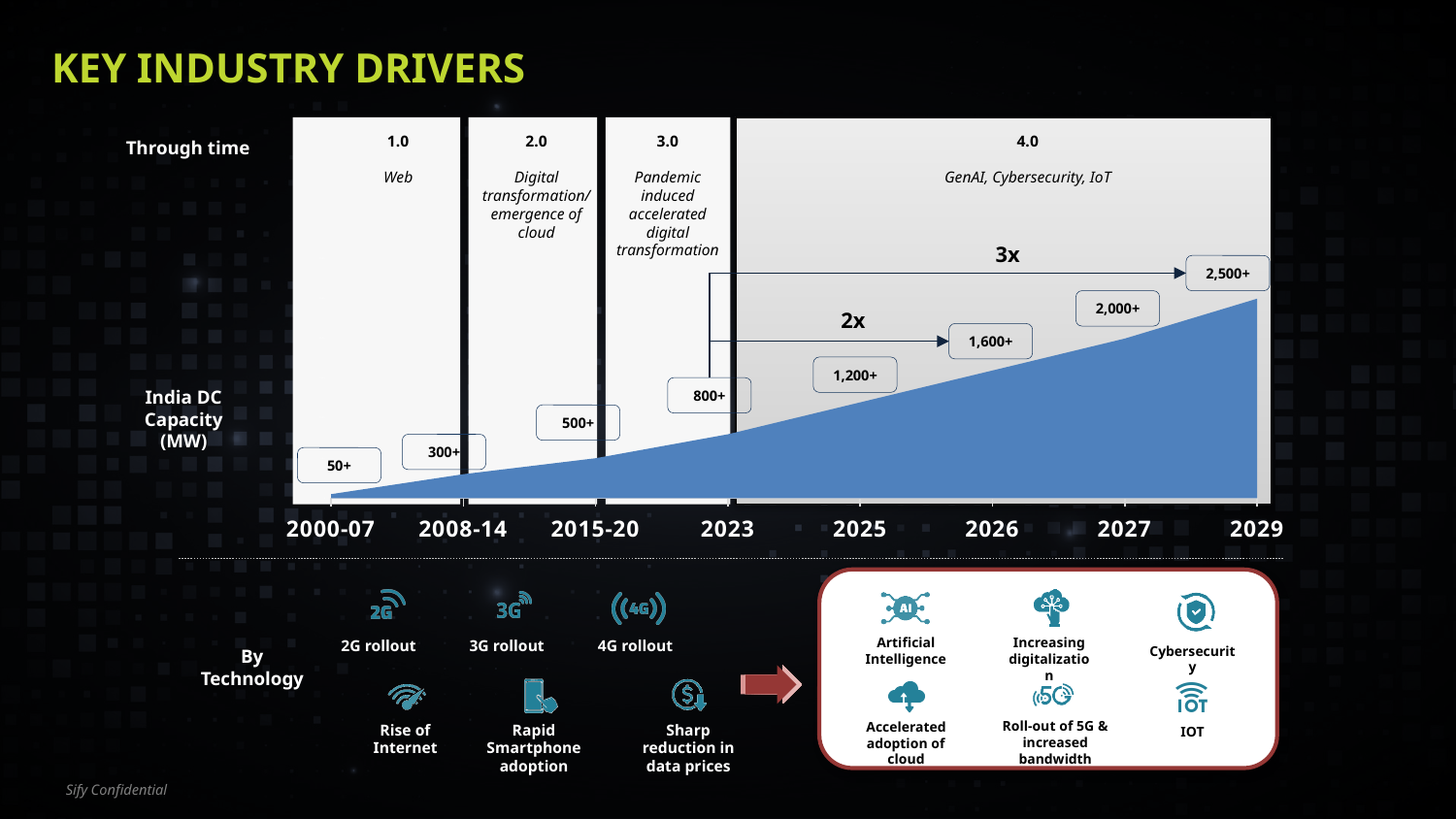
What is the India DC Capacity (MW) shown for 2000-07? 50+ How many time periods are labelled on the x axis of the India DC Capacity chart? 8 What multiplier is annotated between the 2023 capacity and the 2029 capacity? 3x What is the India DC Capacity (MW) shown for 2015-20? 500+ What kind of chart is used to show India DC Capacity (MW)? area chart Which has the larger India DC Capacity, 2025 or 2027? 2027 Which period has the lowest India DC Capacity (MW)? 2000-07 Does India DC Capacity rise or fall from 2000-07 to 2029? rise What is the India DC Capacity (MW) shown for 2023? 800+ What is the India DC Capacity (MW) shown for 2026? 1,600+ What is the India DC Capacity (MW) shown for 2029? 2,500+ Which period has the highest India DC Capacity (MW)? 2029